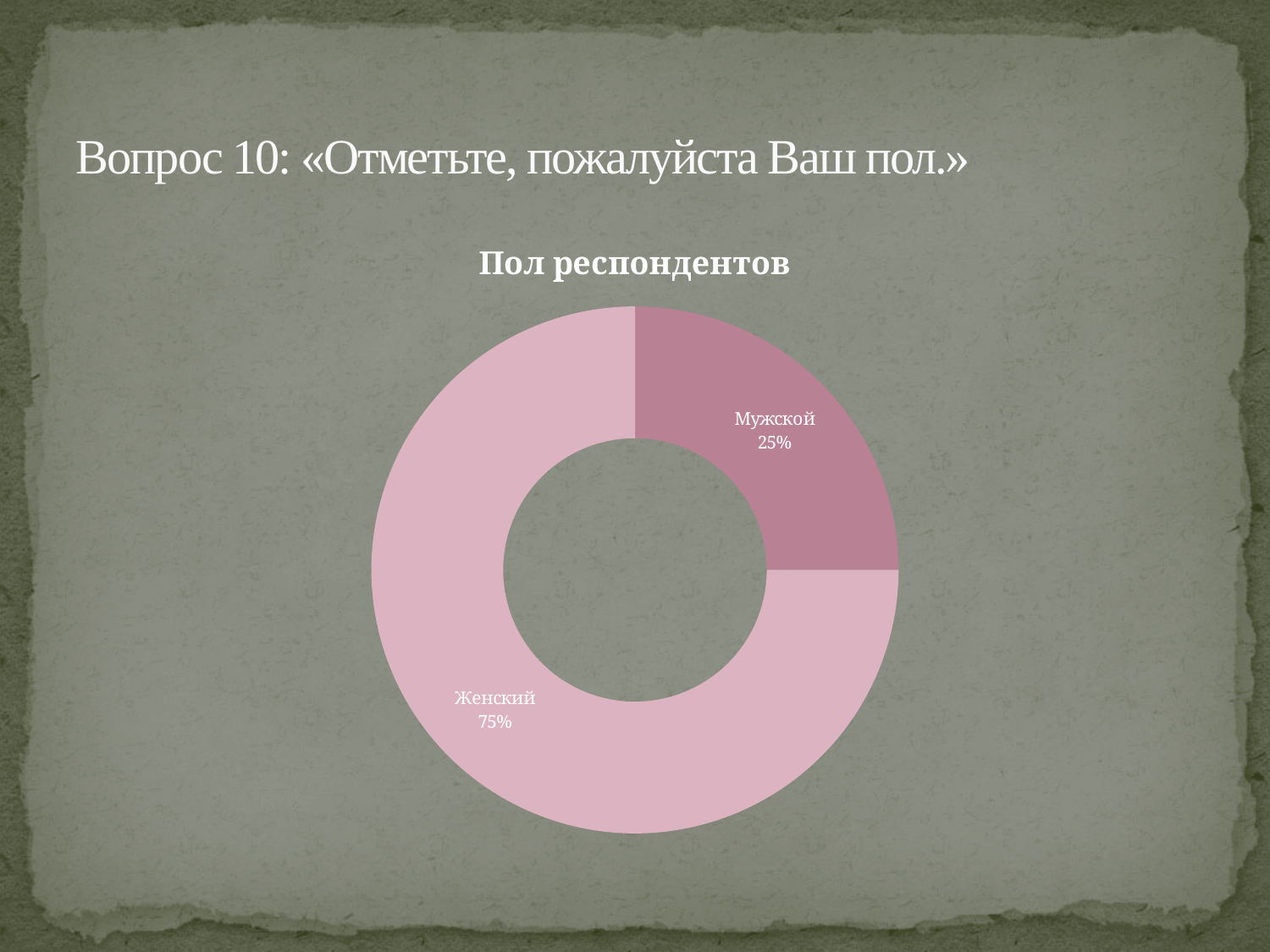
What kind of chart is shown on the slide? Doughnut (pie) chart What is the total of the two shares shown in the chart? 100% Which is larger, the share for Женский or the share for Мужской? Женский How many categories are shown in the chart? 2 What is the title of the chart? Пол респондентов What share of respondents are Женский (female)? 75% What share of respondents are Мужской (male)? 25% Which category has the smallest share of respondents? Мужской Is the share for Мужской greater or less than 50%? less Which category has the largest share of respondents? Женский What is the difference in percentage points between the Женский and Мужской shares? 50%